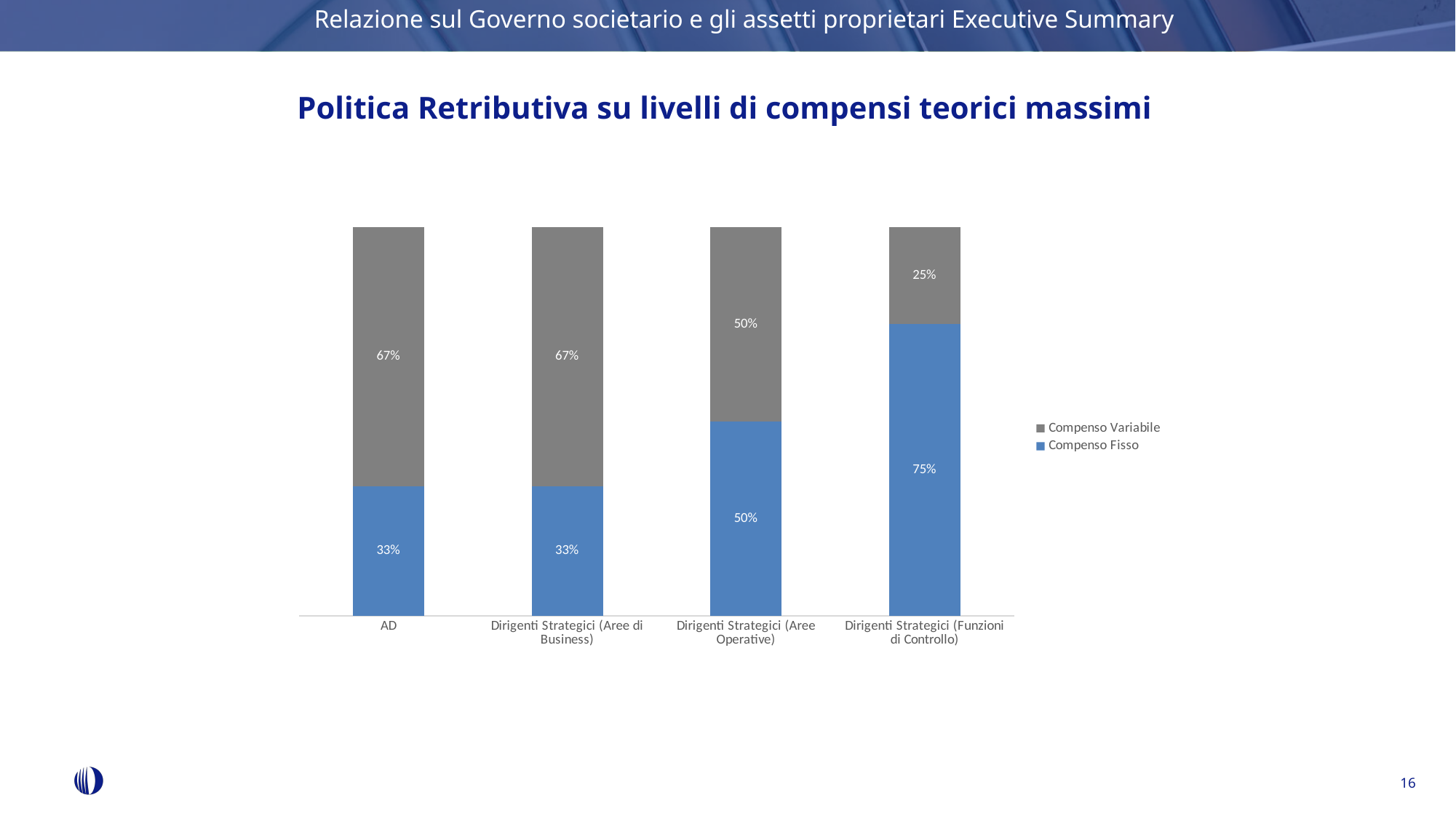
What is the difference between the Compenso Fisso values for Dirigenti Strategici (Funzioni di Controllo) and AD? 42% What kind of chart is shown on the slide? Stacked bar chart Which is larger for Dirigenti Strategici (Aree di Business): Compenso Fisso or Compenso Variabile? Compenso Variabile What is the title of the chart? Politica Retributiva su livelli di compensi teorici massimi What is the Compenso Variabile value for Dirigenti Strategici (Aree di Business)? 67% How many series does the legend list? 2 Which category has the lowest Compenso Variabile value? Dirigenti Strategici (Funzioni di Controllo) How many categories are shown on the x axis? 4 What is the Compenso Variabile value for Dirigenti Strategici (Funzioni di Controllo)? 25% What is the Compenso Fisso value for AD? 33% What is the Compenso Fisso value for Dirigenti Strategici (Aree Operative)? 50% Which category has the highest Compenso Fisso value? Dirigenti Strategici (Funzioni di Controllo)